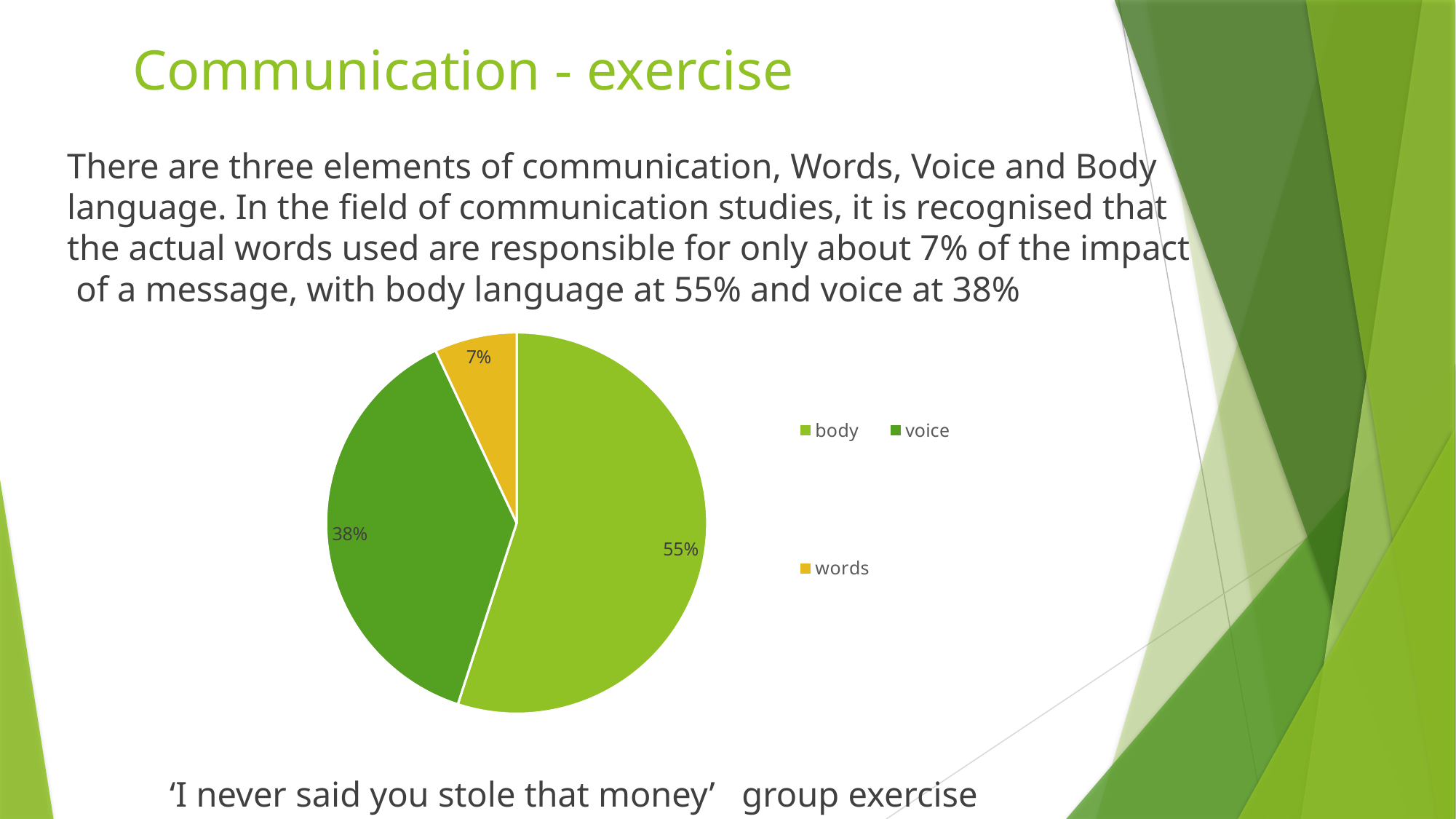
How many entries does the legend of the pie chart list? 3 What percentage does the voice slice represent in the pie chart? 38% Which is larger in the pie chart, voice or words? voice Which category has the smallest slice in the pie chart? words What percentage does the body slice represent in the pie chart? 55% What is the difference in percentage points between the voice slice and the words slice? 31 What colour is the words slice in the pie chart? yellow How many slices does the pie chart have? 3 Which category has the largest slice in the pie chart? body What kind of chart is shown on the slide? pie chart What is the difference in percentage points between the body slice and the voice slice? 17 What percentage does the words slice represent in the pie chart? 7%